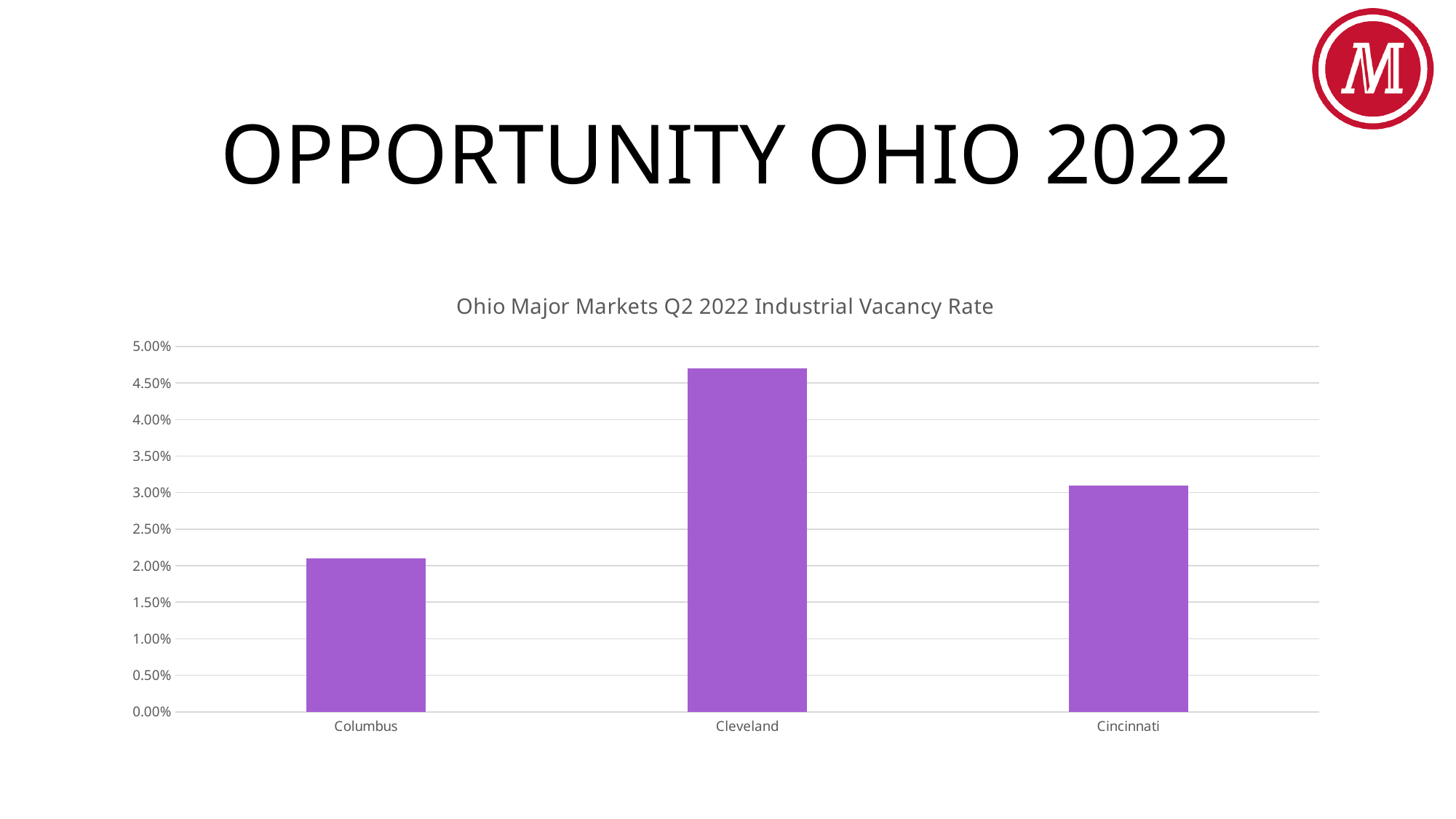
Which market has the lowest industrial vacancy rate? Columbus Which market has the highest industrial vacancy rate? Cleveland What is the title of the chart? Ohio Major Markets Q2 2022 Industrial Vacancy Rate What colour are the bars in the chart? purple Is the vacancy rate for Columbus greater or less than 2.50%? less Which has a higher vacancy rate, Cleveland or Cincinnati? Cleveland Is the vacancy rate for Cincinnati greater or less than 3.00%? greater Which has a higher vacancy rate, Cincinnati or Columbus? Cincinnati Is the vacancy rate for Columbus greater or less than 2.00%? greater What type of chart is shown on the slide? bar chart How many markets are shown in the chart? 3